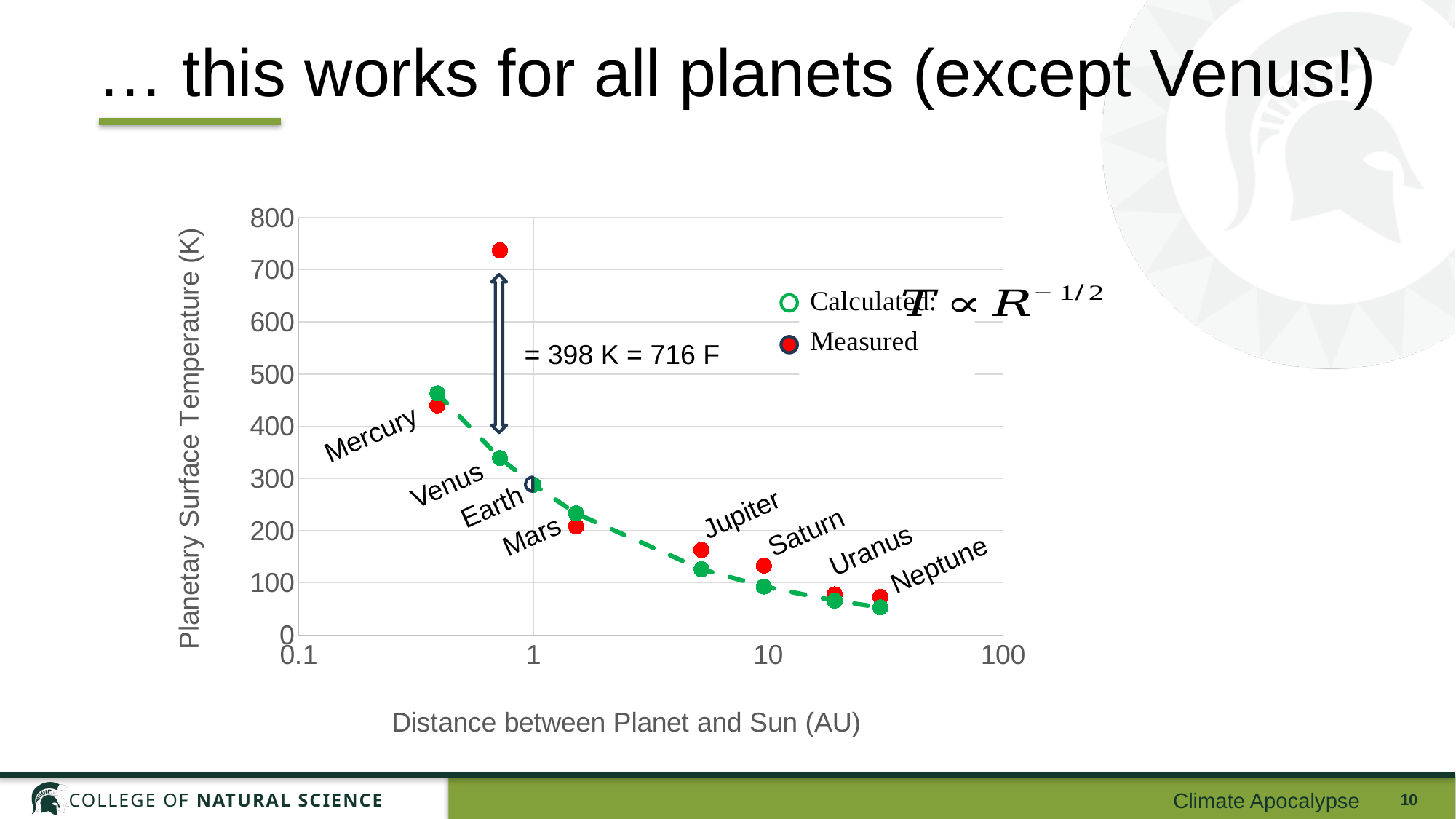
Is the measured surface temperature for Neptune greater or less than 100? less Which has a higher measured surface temperature, Venus or Mercury? Venus How many planets are plotted on the chart? 8 Is the measured surface temperature for Jupiter greater or less than 200? less Is the measured surface temperature for Venus greater or less than 700? greater Ignoring Venus, do surface temperatures rise or fall as distance from the Sun increases? fall How many series does the legend list? 2 What is the title of the x axis? Distance between Planet and Sun (AU) Which planet has the highest measured surface temperature? Venus What kind of chart is shown on the slide? scatter chart Which planet has the lowest surface temperature on the chart? Neptune